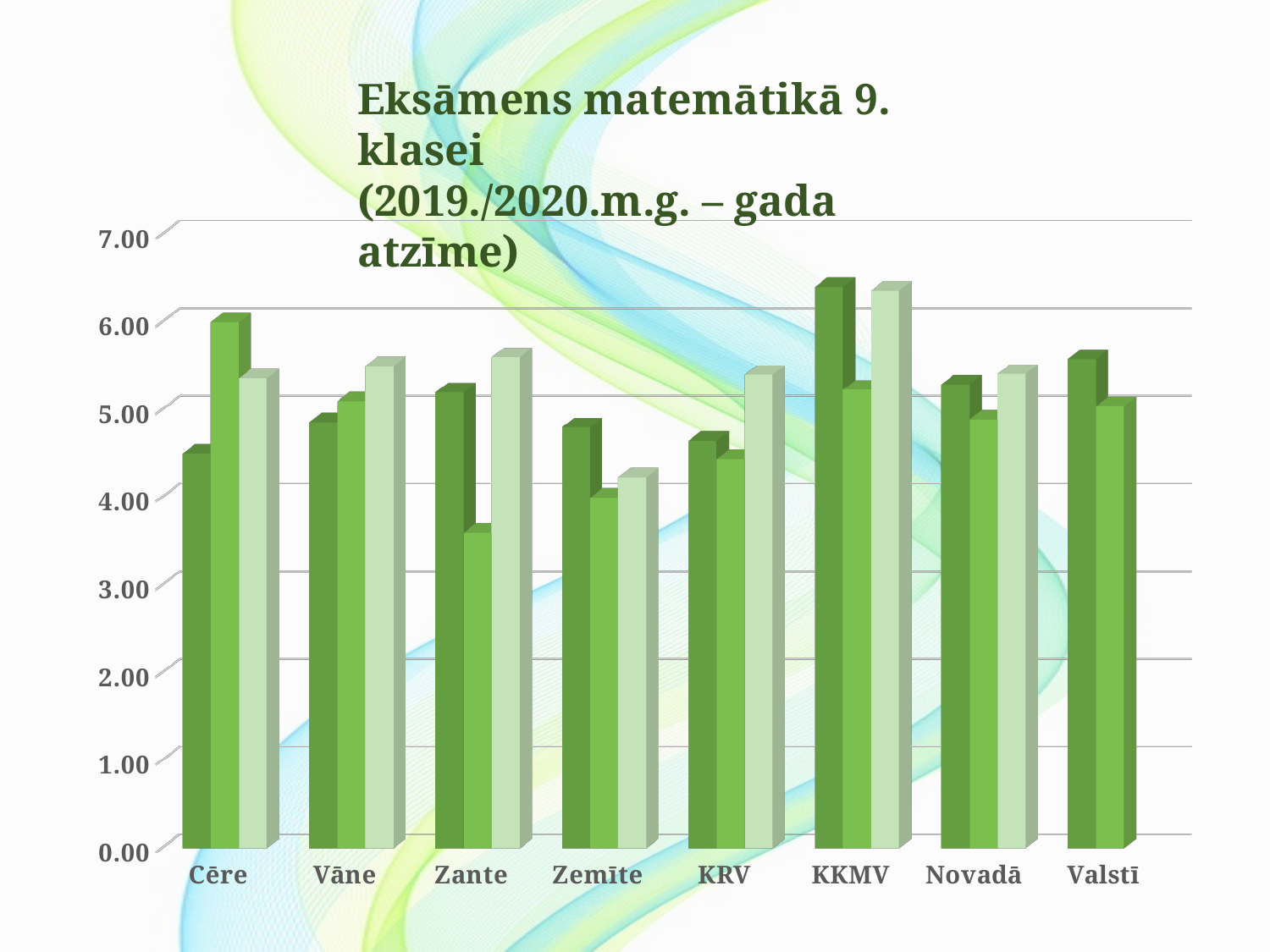
Is the value of the dark green bar for Cēre greater or less than 5.00? less How many bars are shown for the Valstī category? 2 Is the value of the medium green (middle) bar for Zante greater or less than 4.00? less Is the value of the dark green bar for KKMV greater or less than 6.00? greater Which category has the tallest dark green (left) bar? KKMV What kind of chart is shown on the slide? bar chart For Cēre, which is larger: the dark green (left) bar or the medium green (middle) bar? the medium green (middle) bar What is the title of the chart? Eksāmens matemātikā 9. klasei (2019./2020.m.g. – gada atzīme) For Zante, which is larger: the dark green (left) bar or the medium green (middle) bar? the dark green (left) bar Which category has the shortest medium green (middle) bar? Zante How many categories are shown along the x axis of the chart? 8